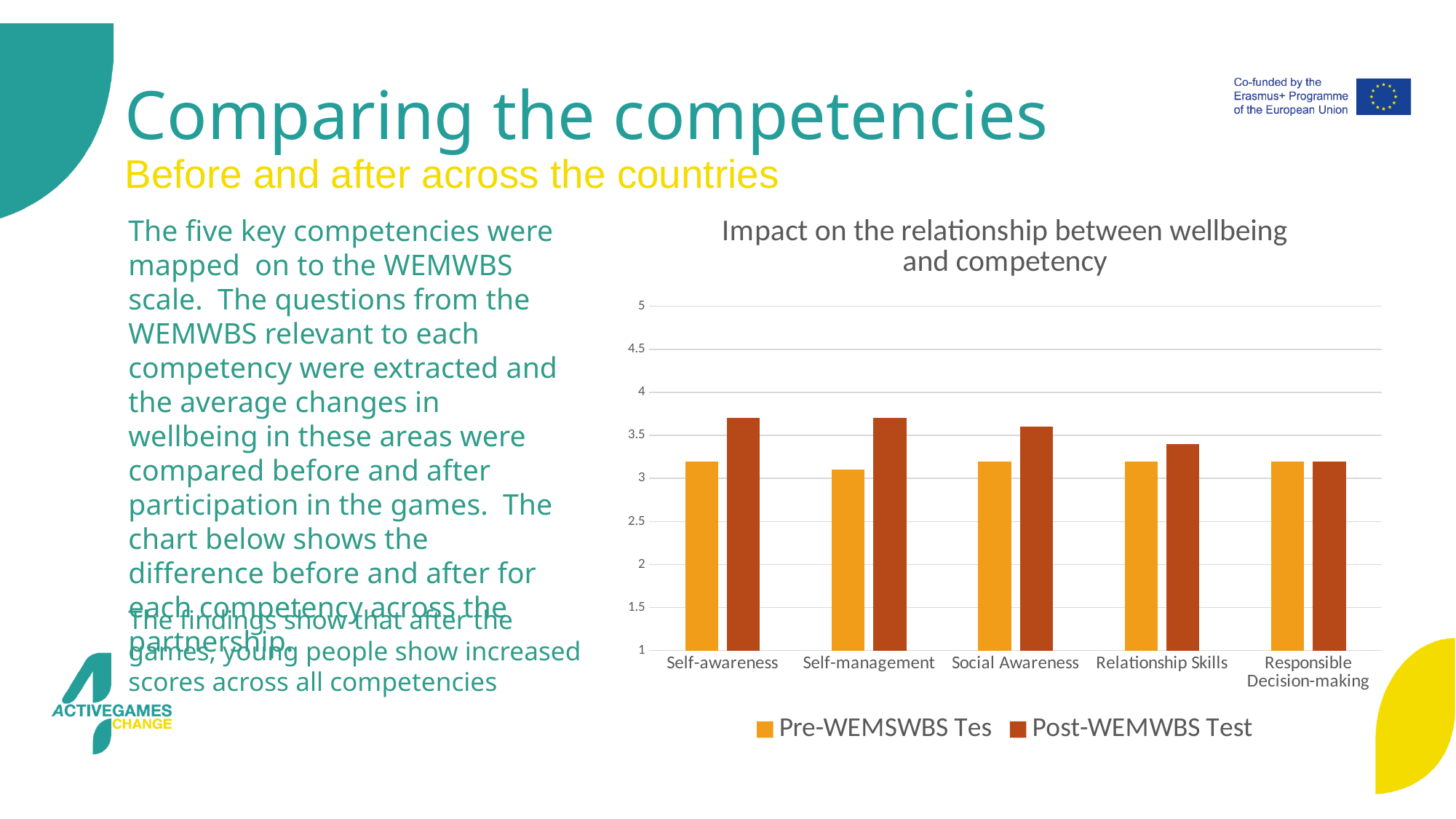
For Self-awareness, which is larger: the Pre-WEMSWBS Tes value or the Post-WEMWBS Test value? Post-WEMWBS Test Is the Post-WEMWBS Test value for Self-awareness greater or less than 3.5? greater Is the Post-WEMWBS Test value for Self-management greater or less than 4? less Which series is shown in dark red/brown in the chart? Post-WEMWBS Test How many series does the chart's legend list? 2 What kind of chart is shown on the slide? Bar chart How many competencies are shown on the x axis of the chart? 5 For Relationship Skills, which is larger: the Pre-WEMSWBS Tes value or the Post-WEMWBS Test value? Post-WEMWBS Test Is the Pre-WEMSWBS Tes value for Social Awareness greater or less than 3? greater What is the title of the chart? Impact on the relationship between wellbeing and competency Which competency has the lowest Post-WEMWBS Test value? Responsible Decision-making